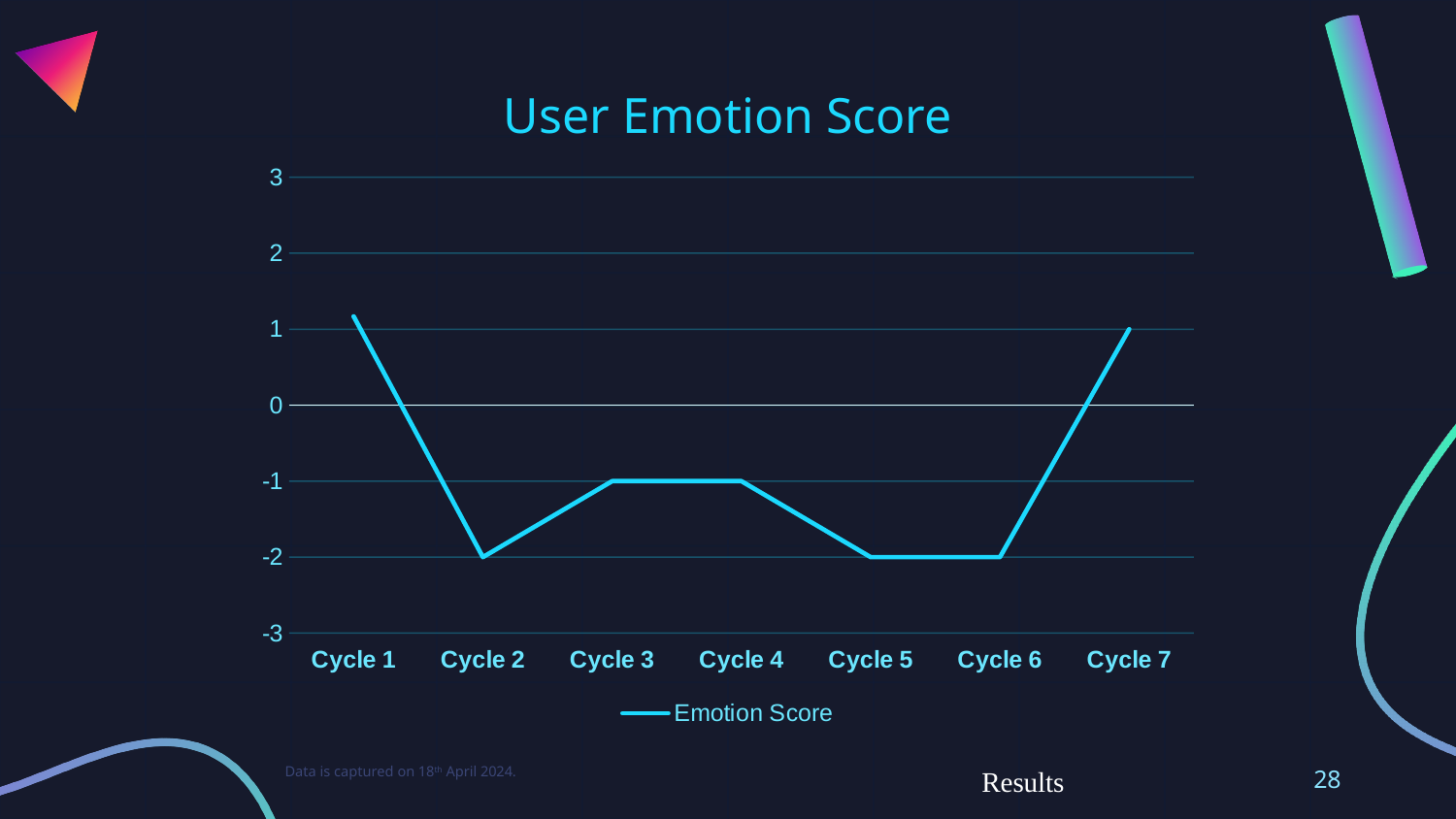
What is the title of the chart? User Emotion Score Which has a higher Emotion Score, Cycle 3 or Cycle 2? Cycle 3 What is the Emotion Score for Cycle 3? -1 What is the Emotion Score for Cycle 5? -2 What is the difference between the Emotion Score for Cycle 7 and Cycle 6? 3 What is the Emotion Score for Cycle 2? -2 What is the Emotion Score for Cycle 7? 1 What kind of chart is shown on the slide? Line chart How many cycles are plotted on the x axis? 7 Is the Emotion Score for Cycle 1 greater or less than 0? greater How many series does the legend list? 1 Does the Emotion Score rise or fall from Cycle 6 to Cycle 7? Rise